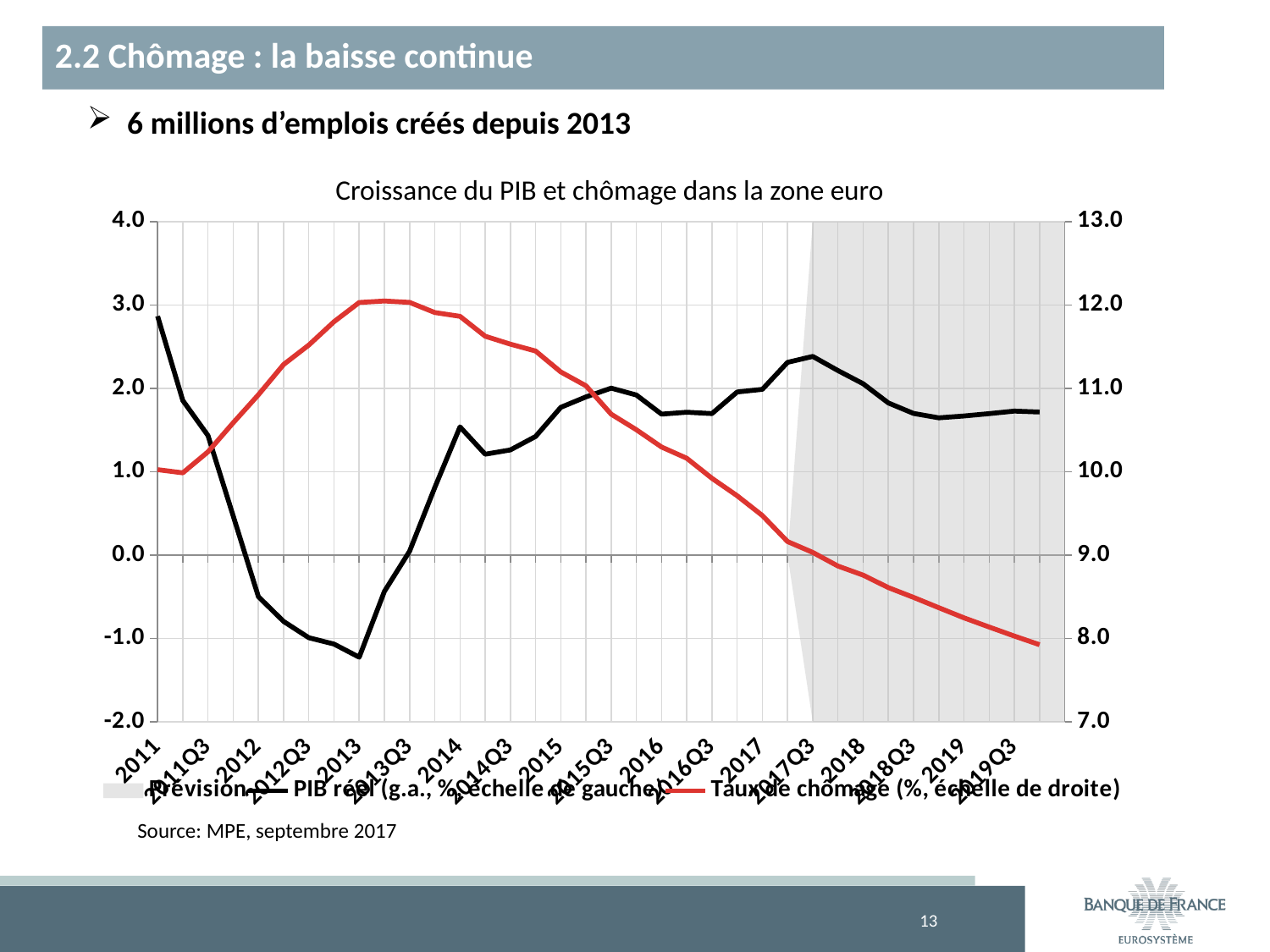
Which is larger, Taux de chômage at 2012 or at 2017? 2012 Which series is plotted on the right-hand axis (échelle de droite)? Taux de chômage Does Taux de chômage rise or fall between 2013Q3 and 2019Q3? fall Is the value of PIB réel at 2017Q3 greater or less than 2.0? greater What kind of chart is shown on the slide? line chart At which x-axis label does PIB réel reach its highest value? 2011 How many entries does the chart legend list? 3 Is the value of Taux de chômage at 2019Q3 greater or less than 9.0? less Is the value of PIB réel at 2013 greater or less than 0.0? less What is the title of the chart? Croissance du PIB et chômage dans la zone euro At which x-axis label does PIB réel reach its lowest value? 2013